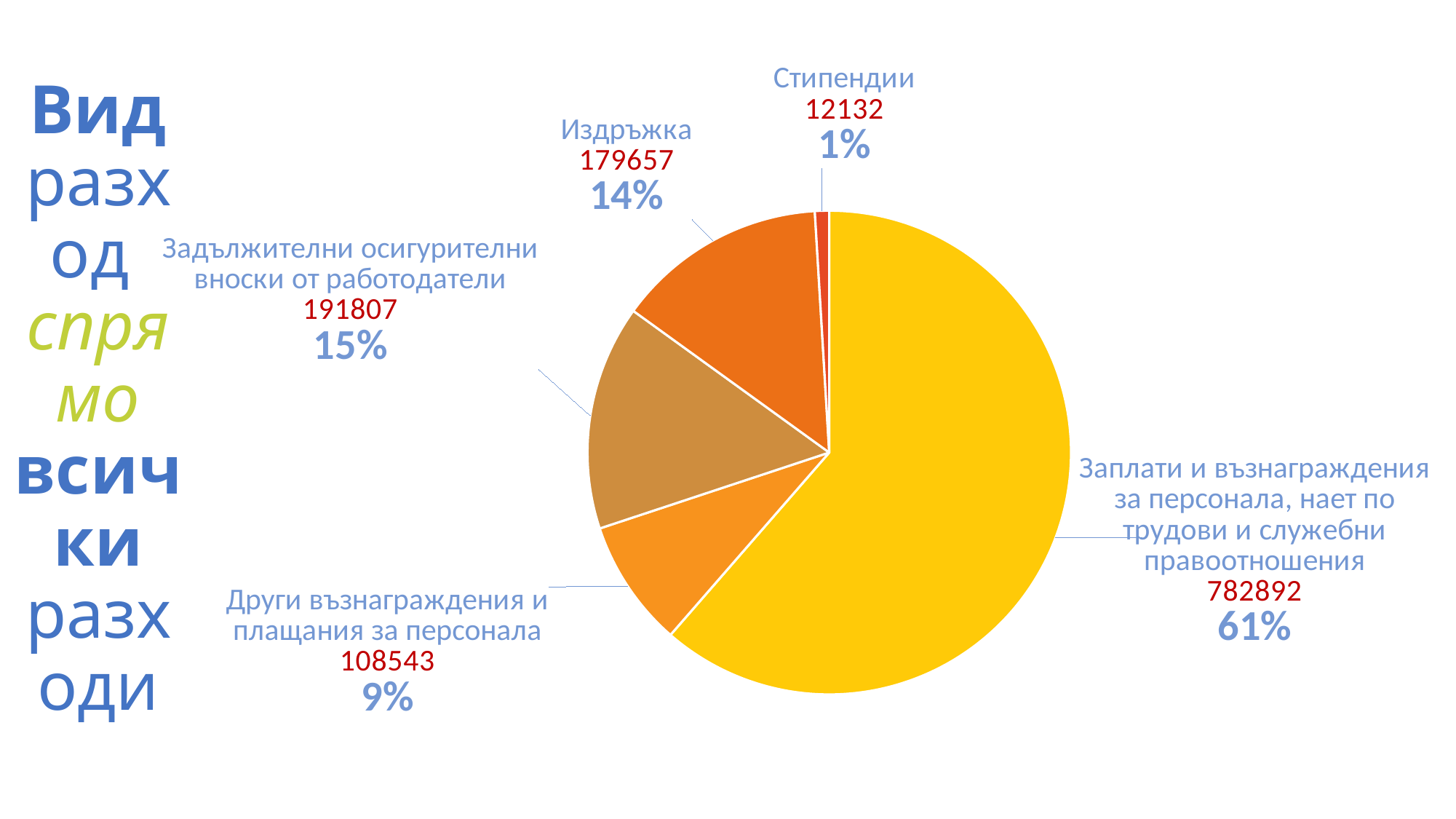
Which is larger, the value for Издръжка or the value for Други възнаграждения и плащания за персонала? Издръжка What percentage share of the pie is Заплати и възнаграждения за персонала, нает по трудови и служебни правоотношения? 61% What is the value shown for Задължителни осигурителни вноски от работодатели? 191807 Which category has the largest slice of the pie? Заплати и възнаграждения за персонала, нает по трудови и служебни правоотношения What is the difference between the values for Задължителни осигурителни вноски от работодатели and Издръжка? 12150 How many slices does the pie chart have? 5 What is the value shown for Други възнаграждения и плащания за персонала? 108543 What is the value shown for Стипендии? 12132 What kind of chart is shown on the slide? pie chart Which category has the smallest slice of the pie? Стипендии What percentage share of the pie is Издръжка? 14% What is the value shown for Издръжка? 179657